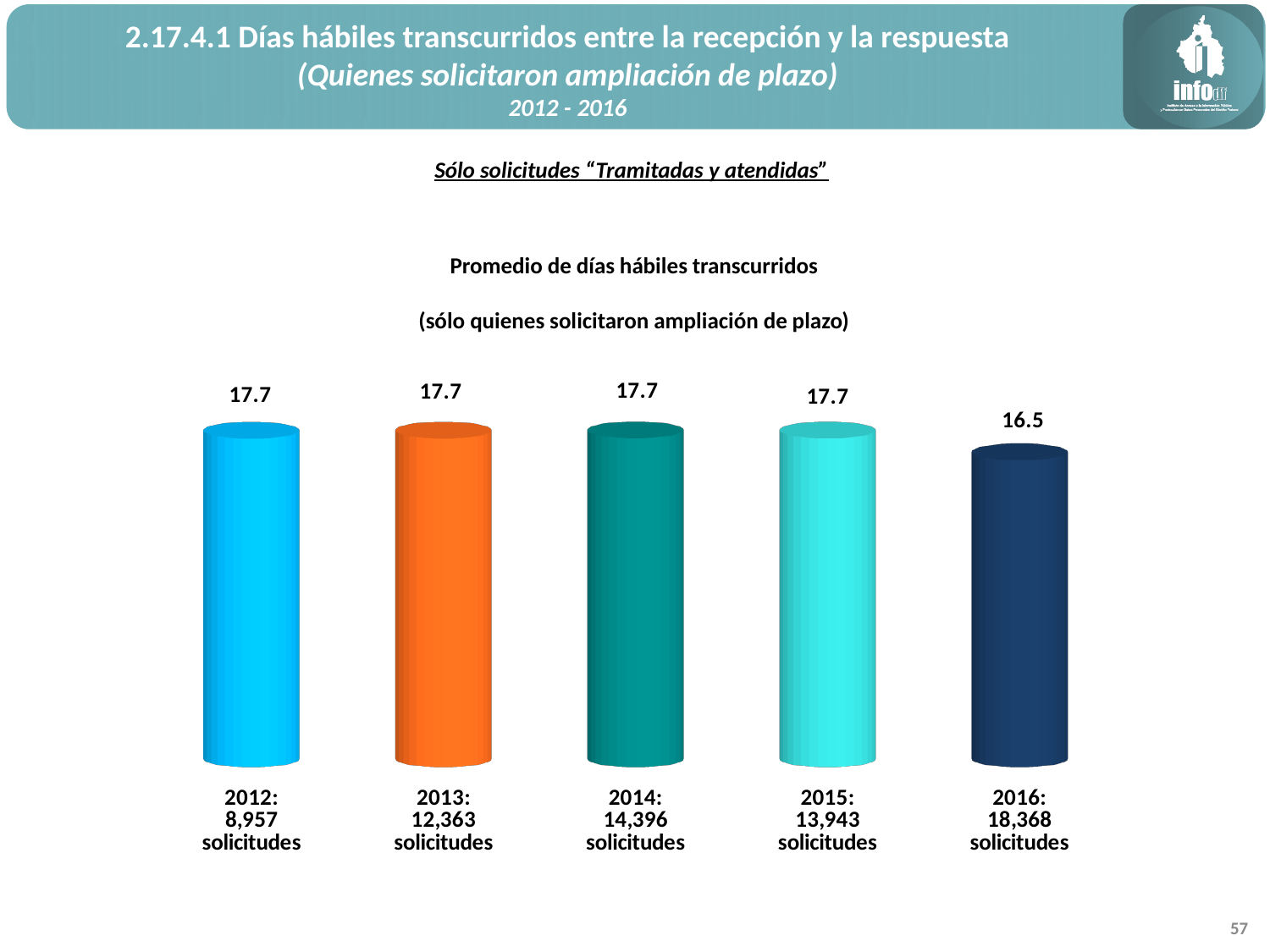
What is the average number of business days elapsed for 2012? 17.7 What is the average number of business days elapsed for 2014? 17.7 How many years share the same average value of 17.7? 4 What is the average number of business days elapsed for 2016? 16.5 How many solicitudes are listed under the 2012 bar? 8,957 solicitudes How many solicitudes are listed under the 2016 bar? 18,368 solicitudes What kind of chart is shown on the slide? bar chart Which year has the lowest average number of business days elapsed? 2016 Is the average for 2013 larger or smaller than the average for 2016? larger Does the average number of business days rise or fall from 2015 to 2016? fall What is the difference between the average for 2015 and the average for 2016? 1.2 How many years are shown in the chart? 5